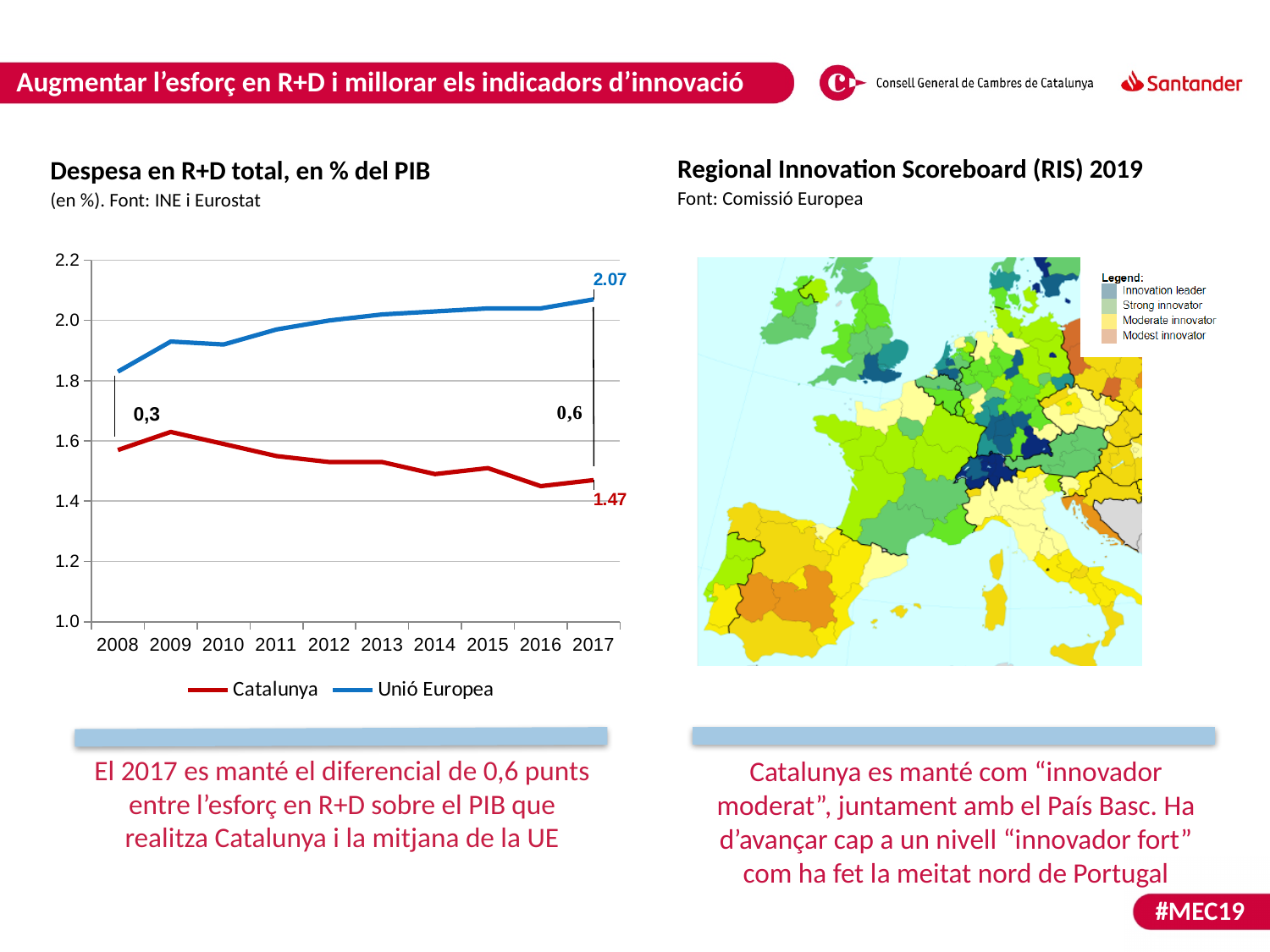
In the chart 'Despesa en R+D total, en % del PIB', in which year does the Catalunya series reach its highest value? 2009 In the chart 'Despesa en R+D total, en % del PIB', does the Unió Europea series generally rise or fall from 2008 to 2017? rise In the chart 'Despesa en R+D total, en % del PIB', does the Catalunya series generally rise or fall from 2009 to 2017? fall In the chart 'Despesa en R+D total, en % del PIB', is the value for Unió Europea in 2008 greater or less than 2.0? less In the chart 'Despesa en R+D total, en % del PIB', which series has the larger value in 2017, Catalunya or Unió Europea? Unió Europea In the chart 'Despesa en R+D total, en % del PIB', what is the value for Catalunya in 2017? 1.47 In the chart 'Despesa en R+D total, en % del PIB', what gap between the two series is annotated for 2017? 0,6 What type of chart is 'Despesa en R+D total, en % del PIB'? line chart How many years are shown on the x axis of the chart 'Despesa en R+D total, en % del PIB'? 10 In the chart 'Despesa en R+D total, en % del PIB', what is the value for Unió Europea in 2017? 2.07 How many series does the legend of the chart 'Despesa en R+D total, en % del PIB' list? 2 In the chart 'Despesa en R+D total, en % del PIB', what gap between the two series is annotated for 2008? 0,3